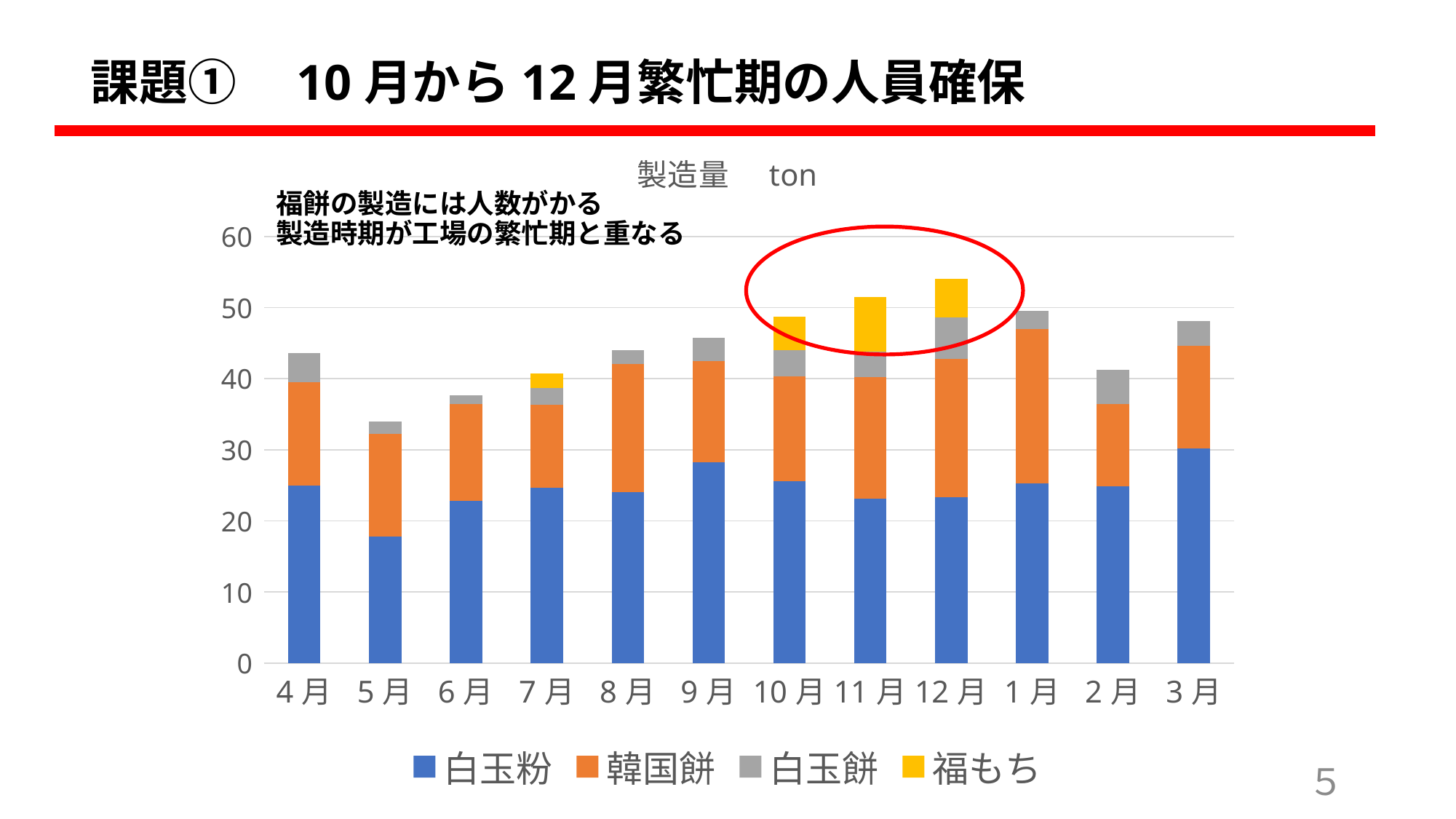
Which month has the larger total production, 9月 or 5月? 9月 Is the total production for 12月 greater or less than 50? greater How many months are shown on the x axis of the chart? 12 How many series does the chart legend list? 4 What kind of chart is shown on the slide? stacked bar chart Is the total production for 5月 greater or less than 40? less In how many months does the 福もち series appear in the chart? 4 Which colour represents 福もち in the chart? yellow Which month has the highest total production in the chart? 12月 What is the title of the chart? 製造量 ton Which month has the lowest total production in the chart? 5月 Is the total production for 3月 greater or less than 50? less